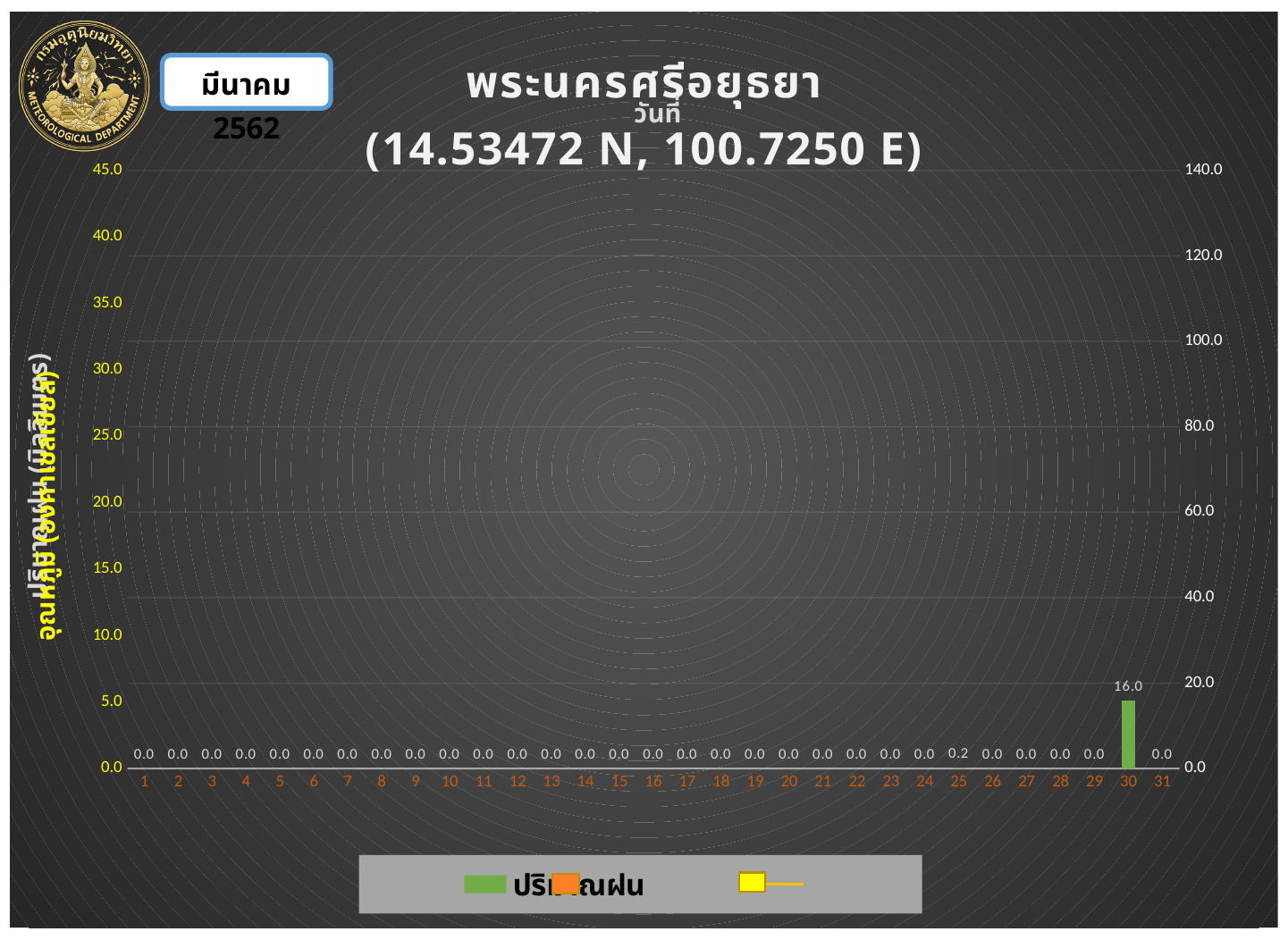
What is the rainfall value shown for day 31? 0.0 What colour are the rainfall bars? green Which day has the highest rainfall value? 30 What kind of chart is used to show the rainfall values? bar chart What is the highest value shown on the left-hand axis? 45.0 What is the highest value shown on the right-hand axis? 140.0 What is the rainfall value shown for day 25? 0.2 What is the rainfall value shown for day 30? 16.0 What is the difference between the rainfall values for day 30 and day 25? 15.8 How many days are shown on the x axis? 31 Which has the larger rainfall value, day 25 or day 30? day 30 What is the rainfall value shown for day 15? 0.0